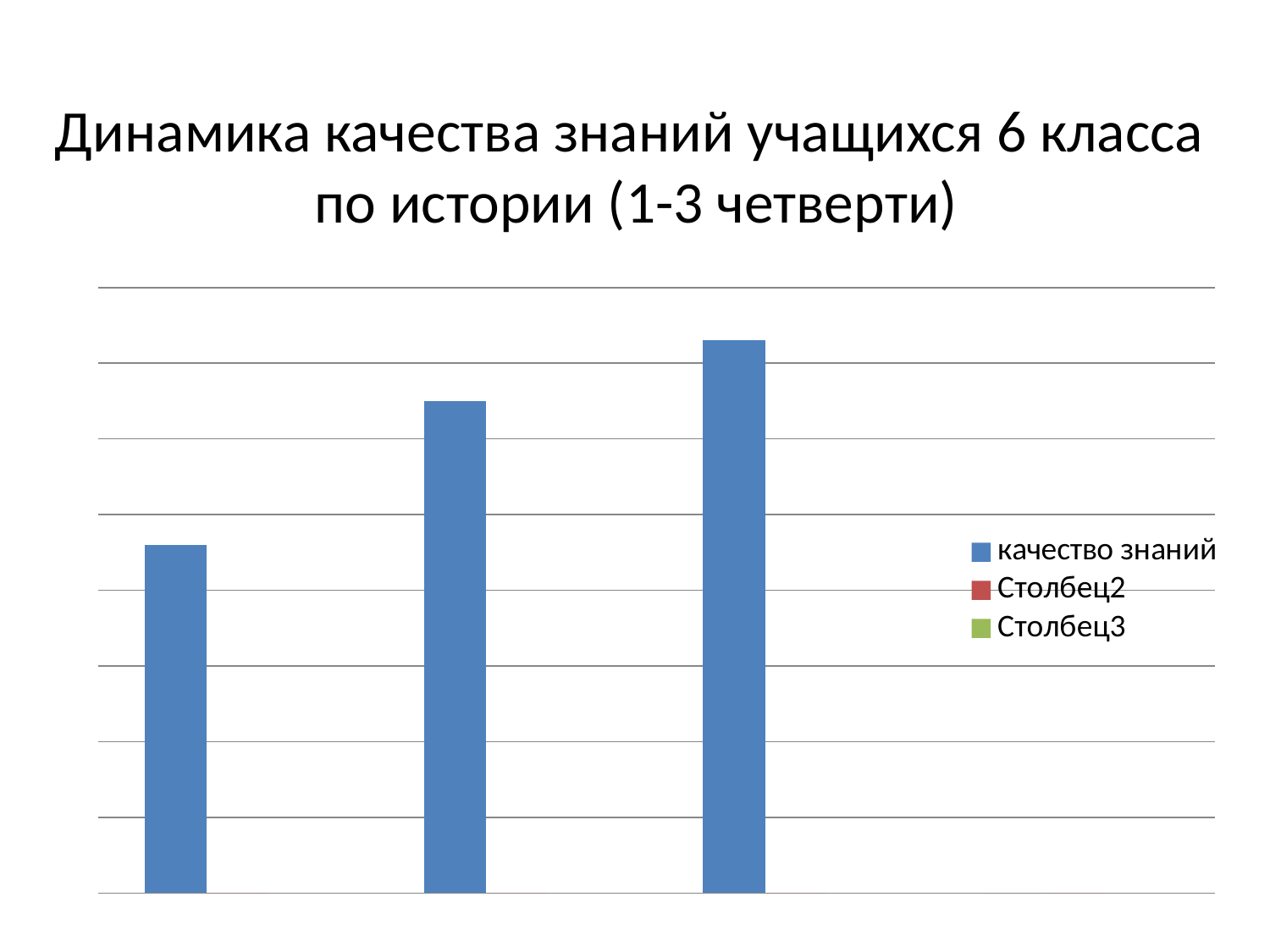
Which bar is the shortest: the first, second or third from the left? first Which is larger, the first bar or the second bar from the left? second bar How many bars are plotted in the chart? 3 What kind of chart is shown on the slide? bar chart Which is larger, the second bar or the third bar from the left? third bar How many series does the legend list? 3 Do the bar values rise or fall from left to right? rise What is the title of the slide? Динамика качества знаний учащихся 6 класса по истории (1-3 четверти) Which legend entry corresponds to the blue bars? качество знаний Which bar is the tallest: the first, second or third from the left? third